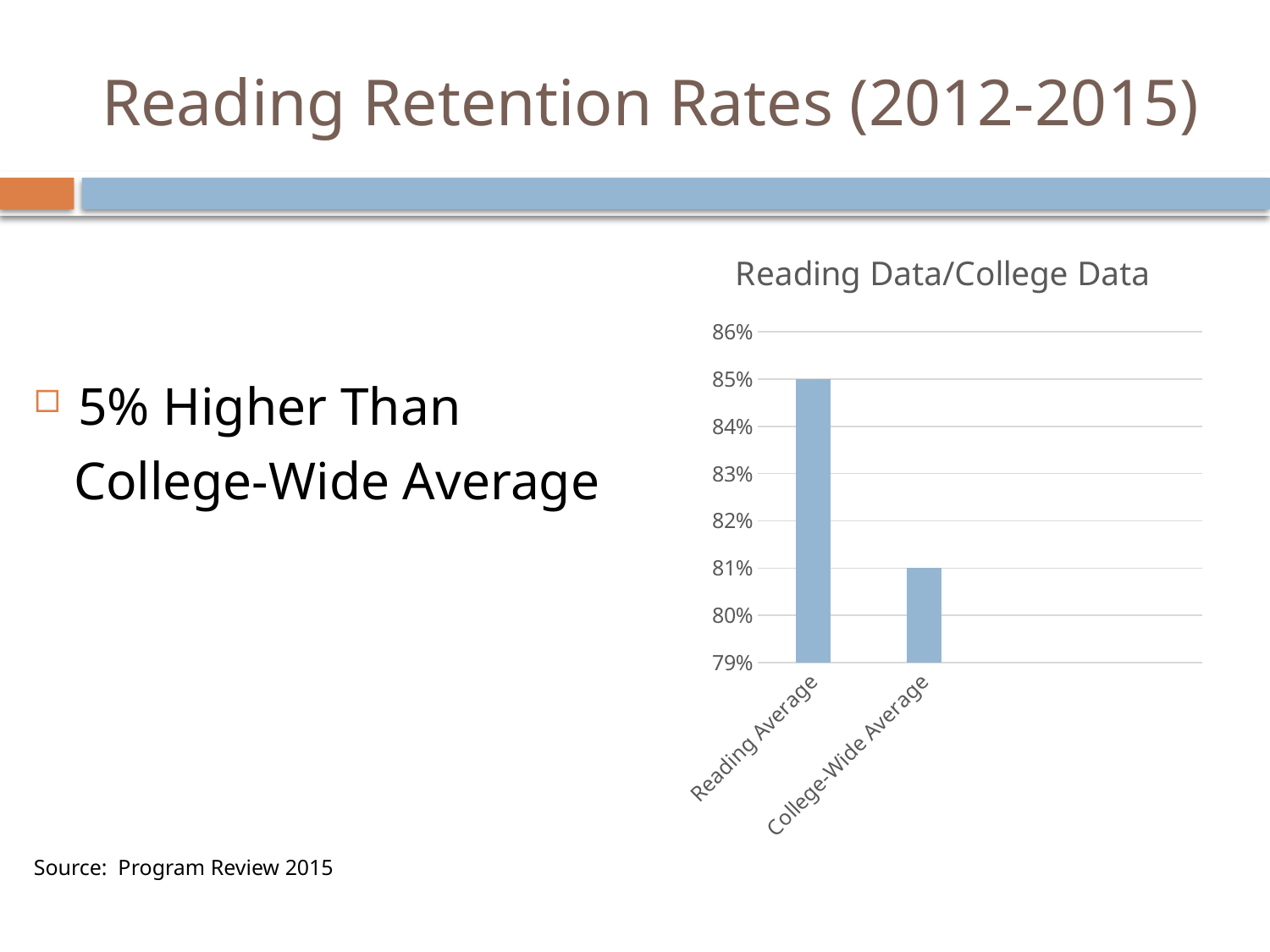
What kind of chart is shown on the slide? bar chart Is the value for Reading Average greater or less than 82%? greater What is the value for Reading Average? 85% What is the value for College-Wide Average? 81% Which is larger, Reading Average or College-Wide Average? Reading Average What is the highest value shown on the vertical axis? 86% Do the values rise or fall from left to right along the x axis? fall Is the value for College-Wide Average greater or less than 83%? less How many categories are shown in the chart? 2 Which category has the lowest value? College-Wide Average What is the title of the chart? Reading Data/College Data Which category has the highest value? Reading Average